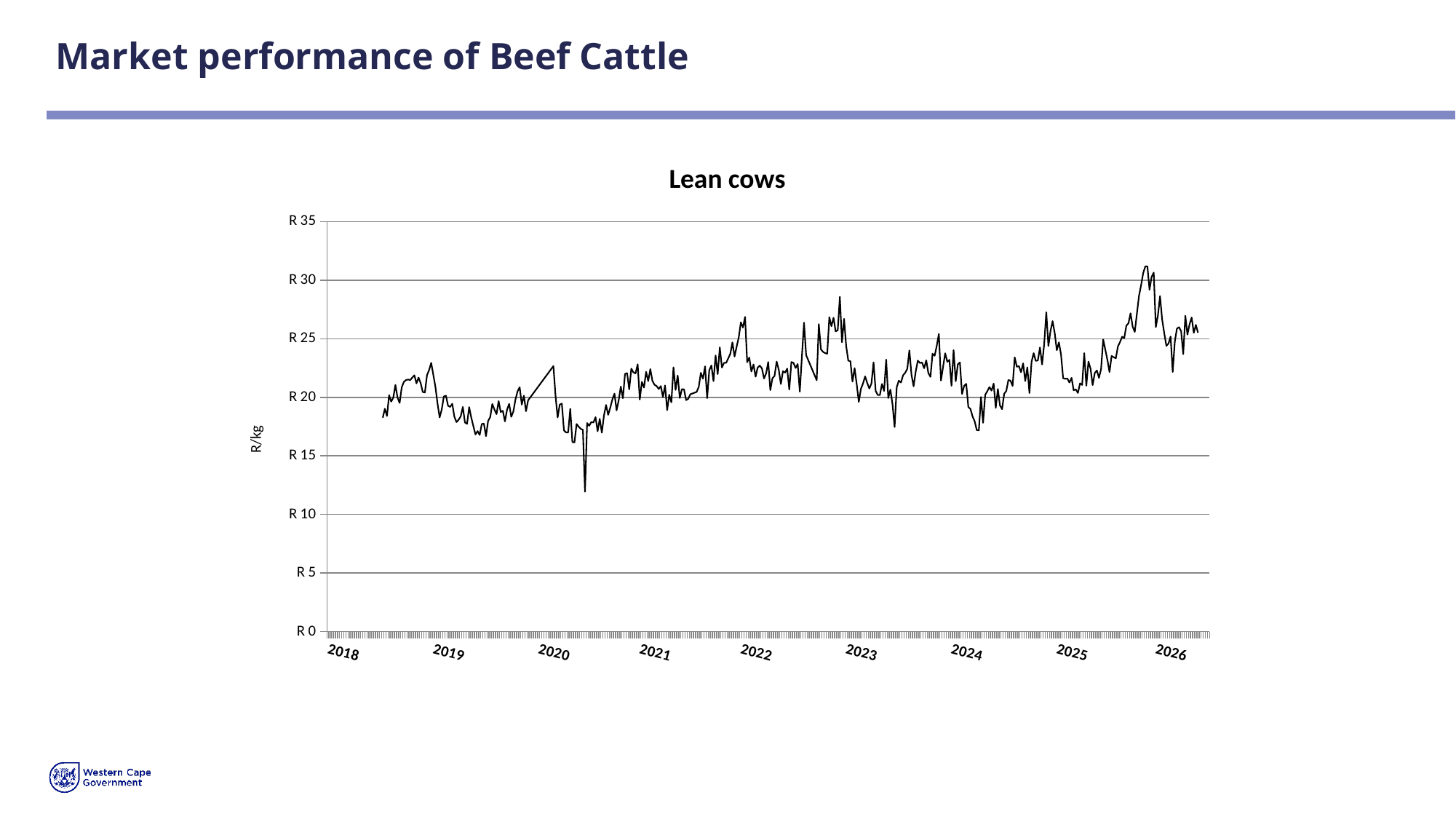
What kind of chart is shown on the slide? line chart Is the sharp dip in 2020 greater or less than R 10? greater What is the title of the chart? Lean cows Which is larger: the peak value in late 2025 or the peak value in 2019? the peak in late 2025 Overall, do the values rise or fall from 2018 to 2026? rise Is the lowest value reached by the line (the sharp dip in 2020) greater or less than R 15? less Is the value at the end of the line in 2026 greater or less than R 30? less What is the label on the vertical axis of the chart? R/kg What is the highest value shown on the vertical axis? R 35